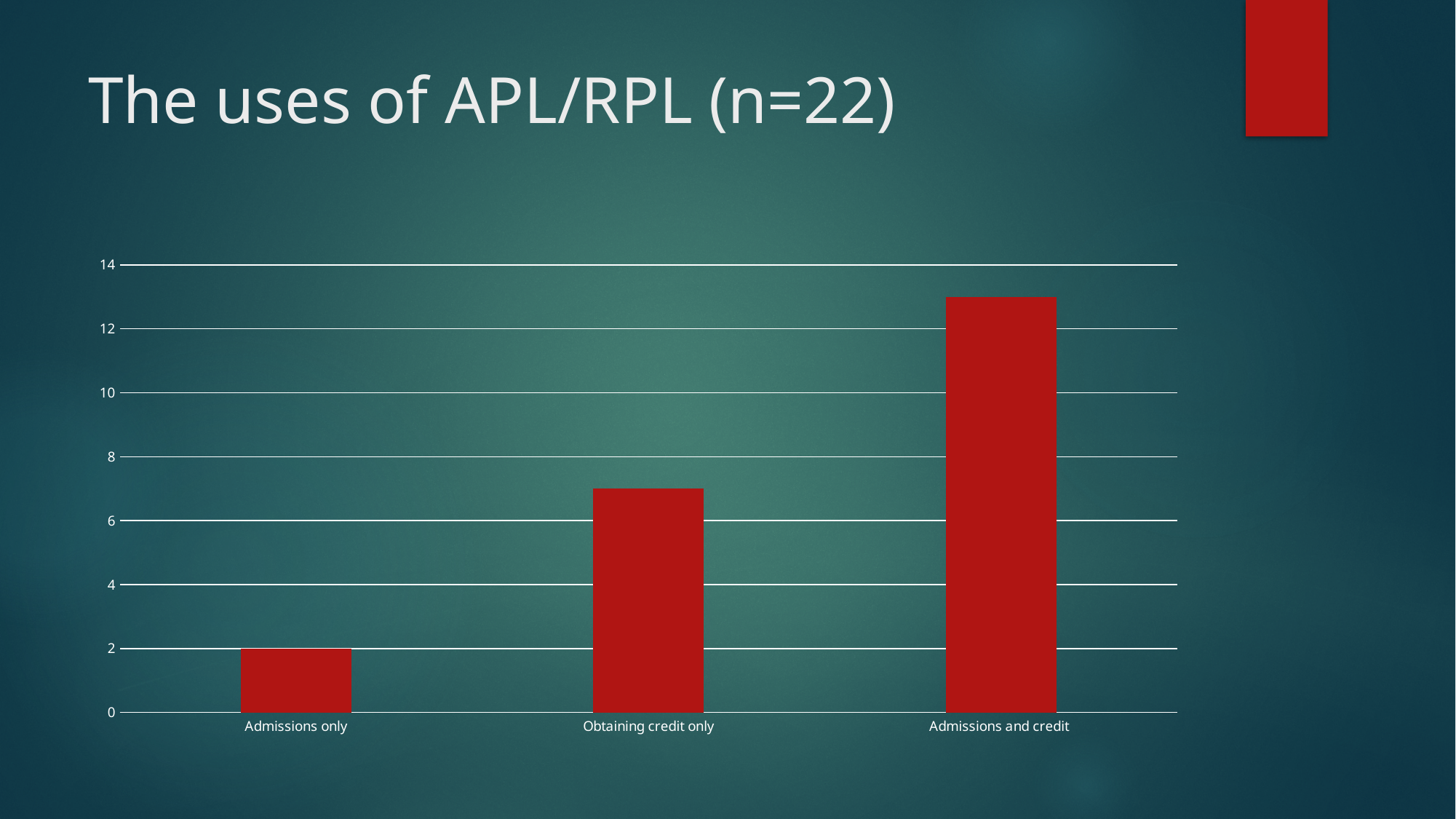
Is the value for Obtaining credit only greater or less than 8? less Is the value for Admissions and credit greater or less than 14? less What type of chart is shown on the slide? bar chart Which category has the highest value? Admissions and credit How many categories are shown on the x axis of the chart? 3 Which is larger, the value for Obtaining credit only or the value for Admissions and credit? Admissions and credit Which category has the lowest value? Admissions only Is the value for Obtaining credit only greater or less than 6? greater Do the values rise or fall moving from left to right along the x axis? rise What is the title of the chart on the slide? The uses of APL/RPL (n=22) What is the value for Admissions only? 2